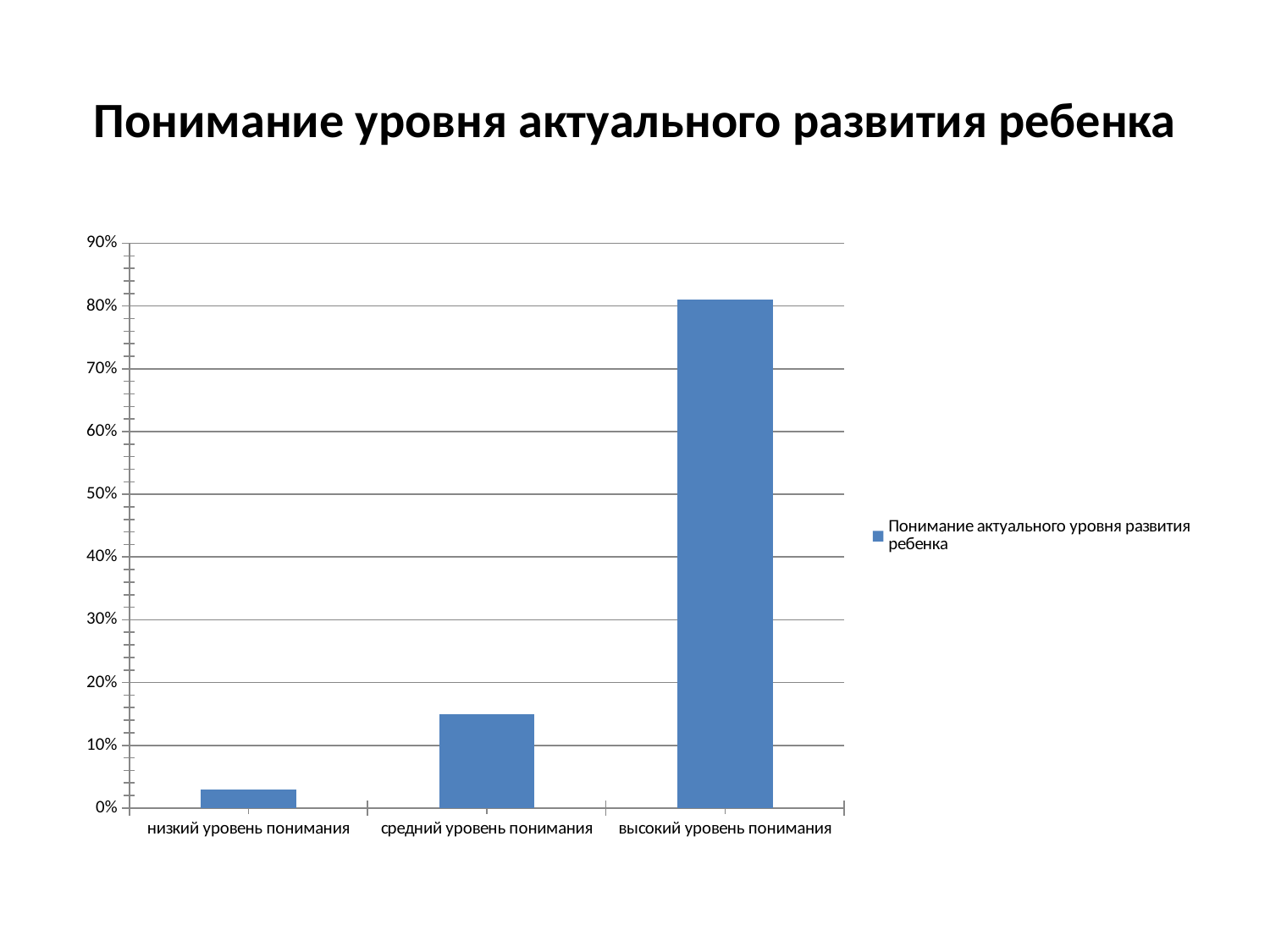
What is the title of the slide? Понимание уровня актуального развития ребенка Do the values rise or fall from left to right along the x axis? rise Is the value for средний уровень понимания greater or less than 10%? greater Is the value for низкий уровень понимания greater or less than 10%? less Is the value for высокий уровень понимания greater or less than 70%? greater Which is larger, the value for средний уровень понимания or the value for низкий уровень понимания? средний уровень понимания What kind of chart is shown on the slide? bar chart Which category has the lowest value? низкий уровень понимания Which category has the highest value? высокий уровень понимания How many series does the legend list? 1 How many categories are shown on the x axis of the chart? 3